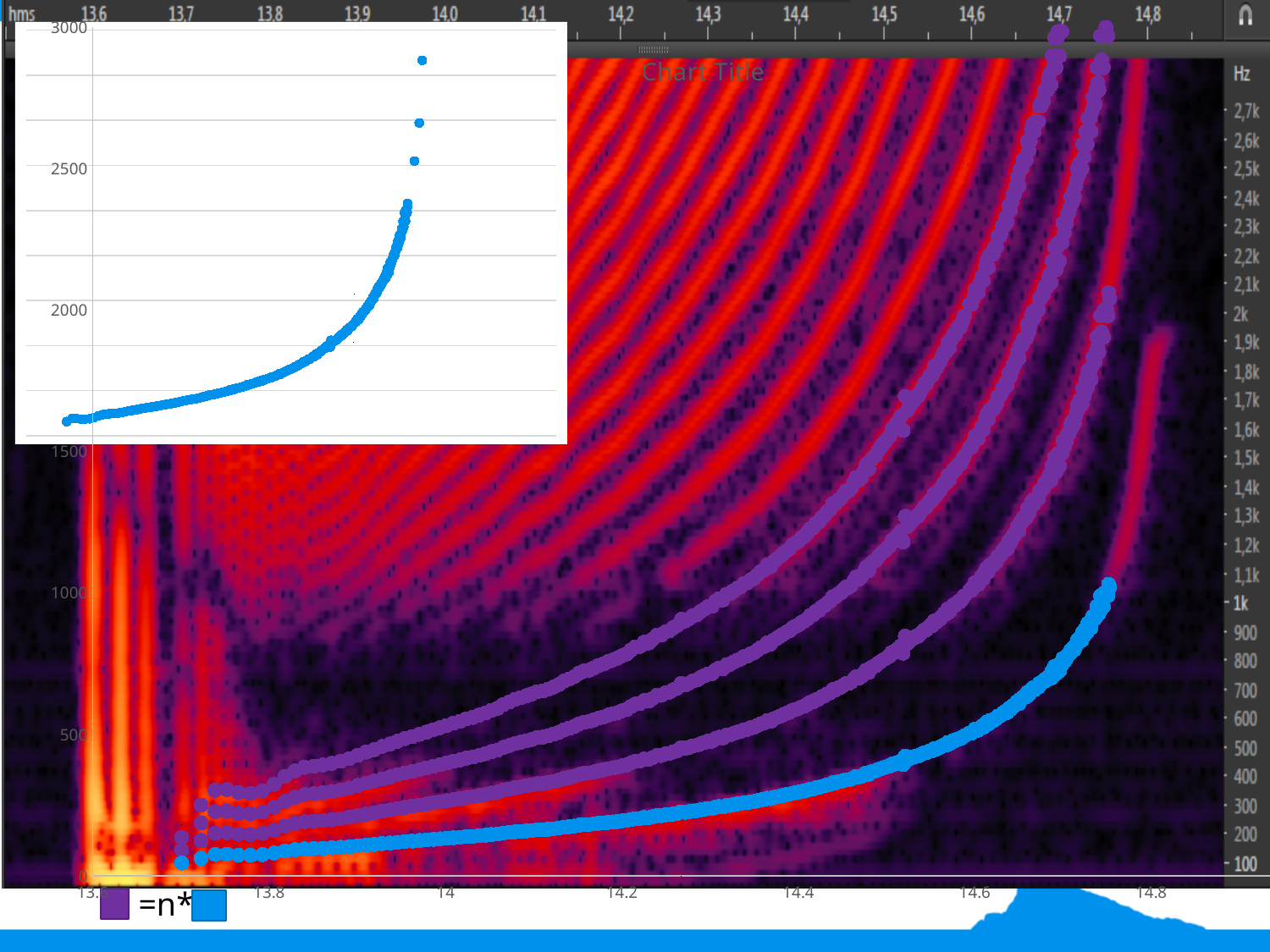
On the large chart, do the purple series values rise or fall as the x axis increases? rise What kind of chart is the large chart with the title "Chart Title"? scatter chart What is the title shown on the large chart? Chart Title On the large chart, is the blue series value at x = 14.4 greater or less than 500? less On the small inset chart in the top-left corner, is the highest plotted value greater or less than 2500? greater On the small inset chart in the top-left corner, is the leftmost plotted value greater or less than 2000? less On the small inset chart in the top-left corner, do the values rise or fall as the x axis increases? rise On the large chart, do the blue series values rise or fall as the x axis increases from 13.6 to 14.8? rise On the large chart, at x = 14.6, which series has the larger value, purple or blue? purple What two colours are used for the series in the large chart? purple and blue